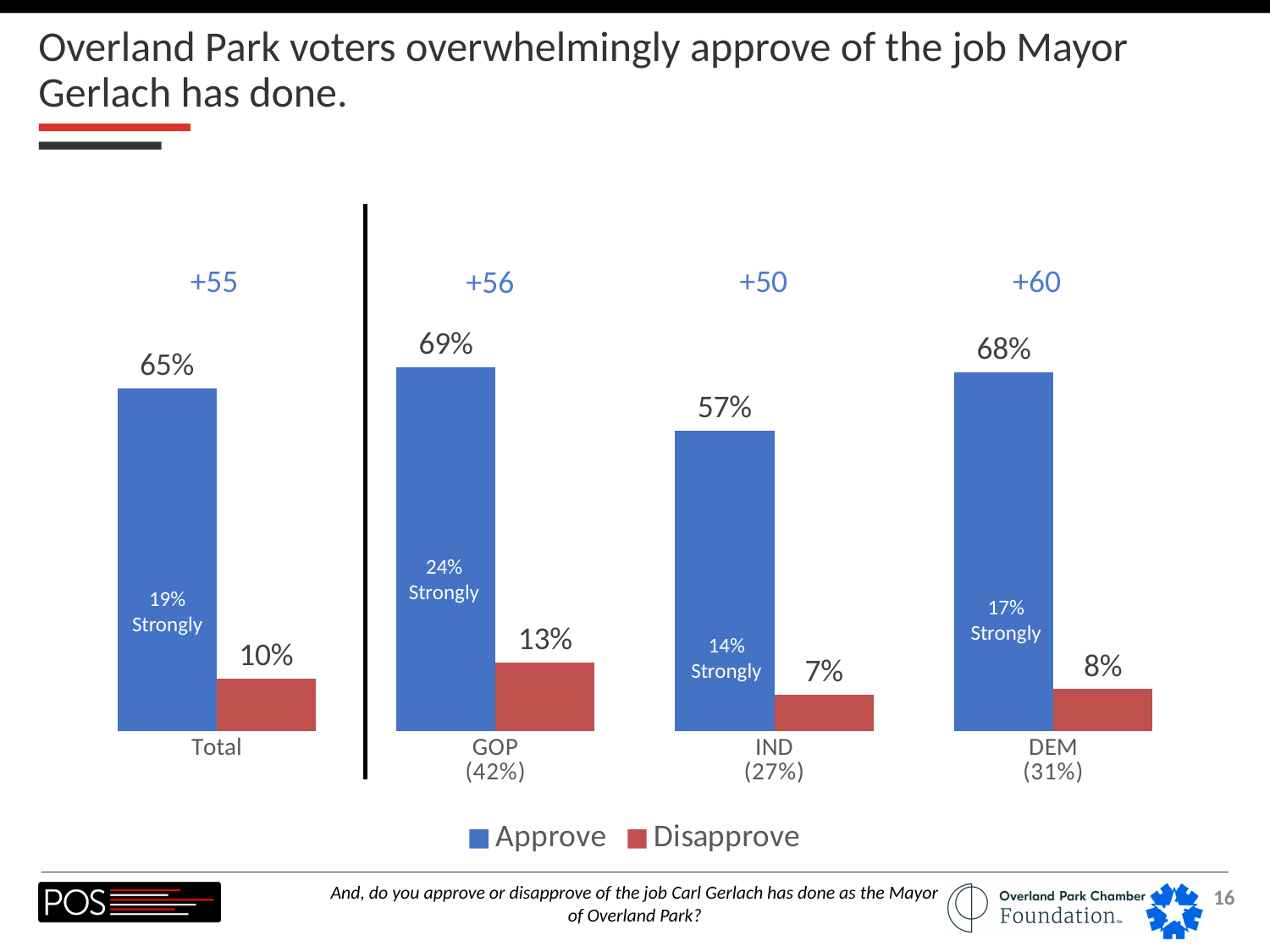
Which category has the lowest Disapprove value? IND How many categories are shown on the x axis? 4 Which category has the highest Approve value? GOP What is the Approve value for Total? 65% What is the difference between the Approve and Disapprove values for DEM? 60 percentage points What is the Disapprove value for DEM? 8% Which is larger, the Approve value for IND or the Approve value for DEM? DEM What is the Approve value for IND? 57% What is the Disapprove value for GOP? 13% What kind of chart is shown on the slide? Bar chart What colour are the Disapprove bars? Red How many series does the legend list? 2